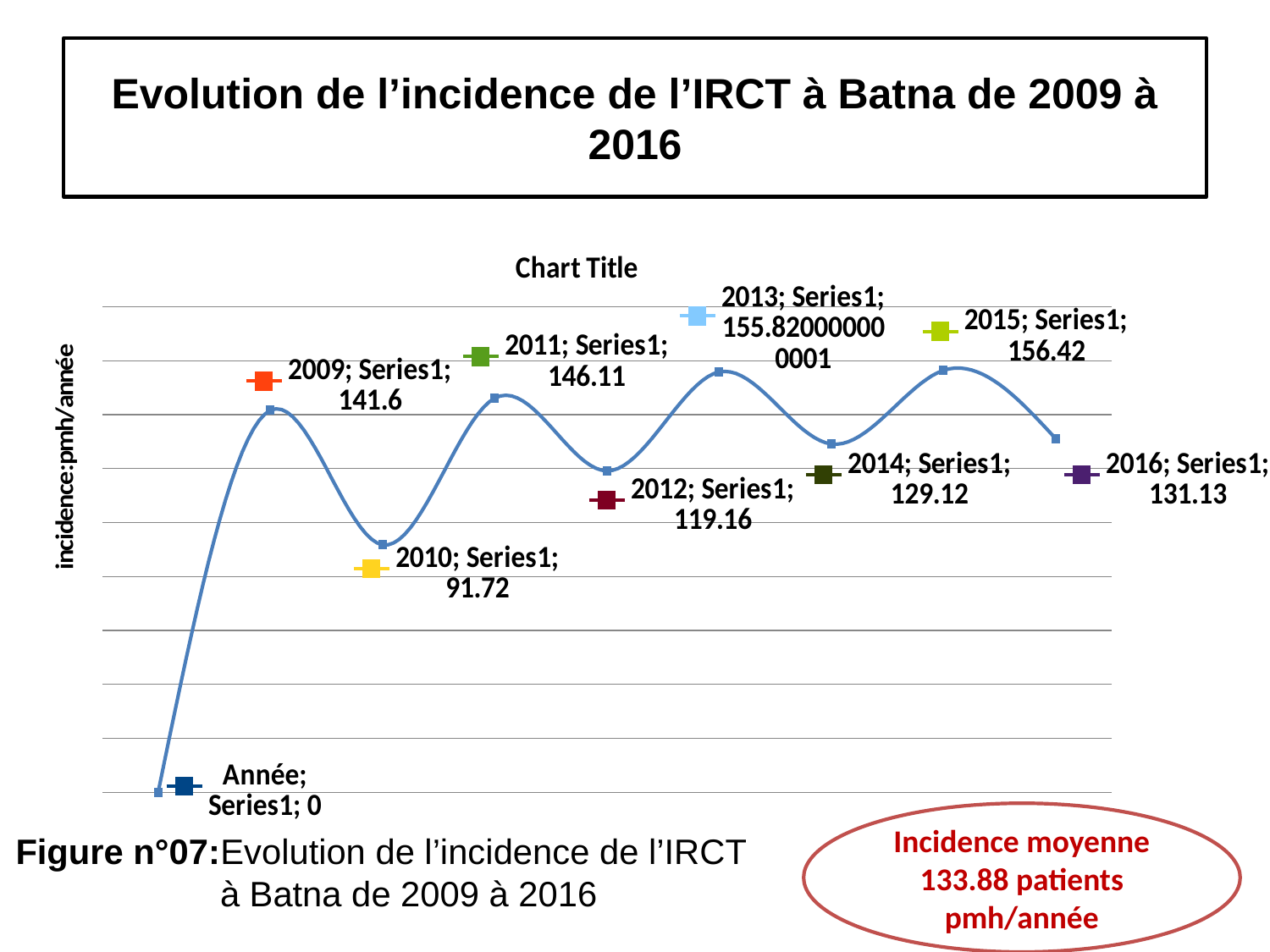
What is the value for 2014? 129.12 What is the value for 2016? 131.13 Which year from 2009 to 2016 has the lowest value? 2010 What kind of chart is shown? line chart Which is larger, the value for 2012 or the value for 2016? 2016 What is the y-axis title of the chart? incidence:pmh/année Which year from 2009 to 2016 has the highest value? 2015 What is the difference between the values for 2015 and 2014? 27.3 What is the difference between the values for 2011 and 2010? 54.39 How many years from 2009 to 2016 are plotted on the chart? 8 What is the value for 2009? 141.6 What is the value for 2010? 91.72